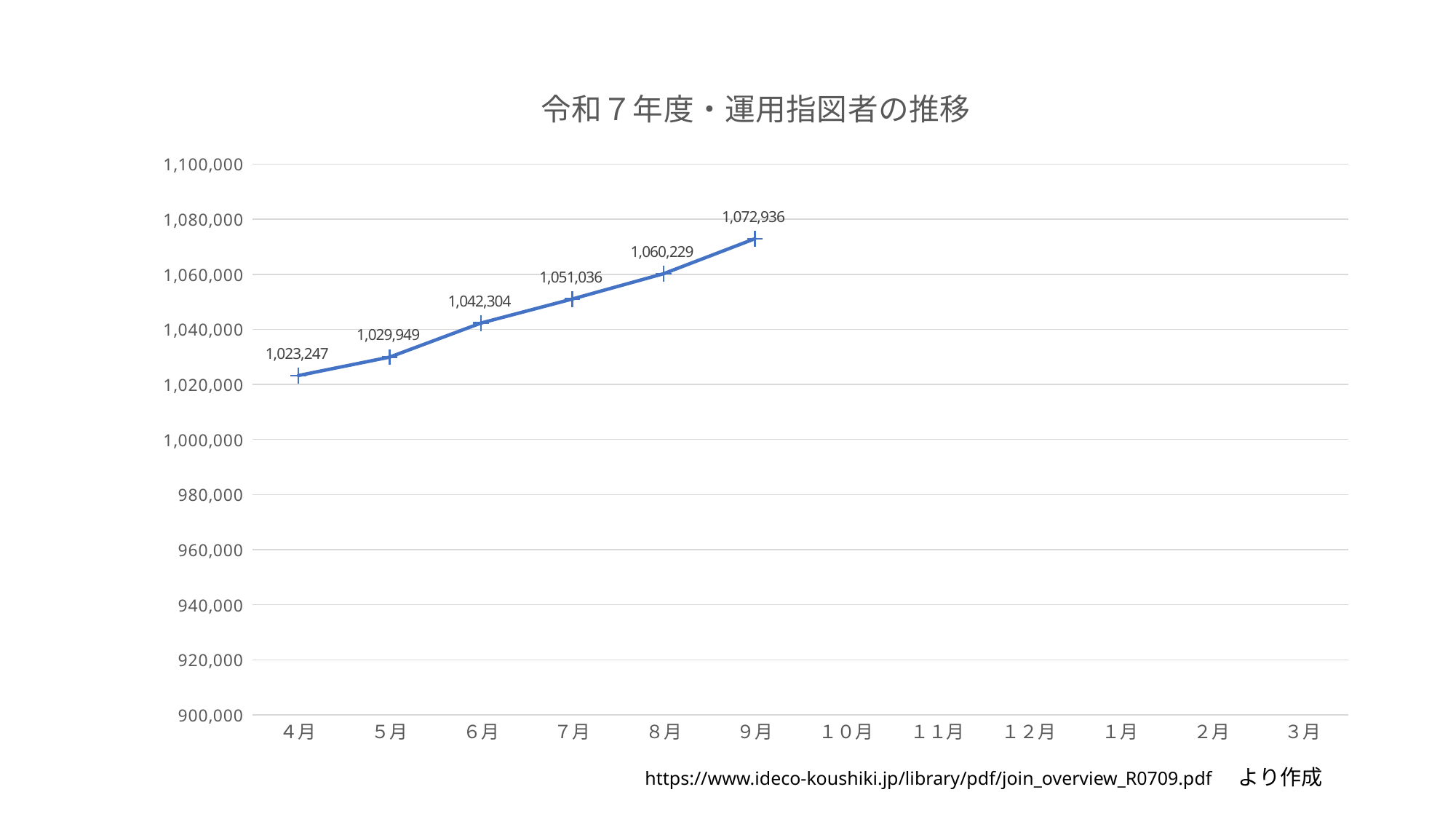
What is the value for 4月? 1,023,247 Do the values rise or fall from 4月 to 9月? rise Which is larger, the value for 8月 or the value for 6月? 8月 How many data points are plotted on the line? 6 What is the value for 7月? 1,051,036 What kind of chart is this? line chart Is the value for 8月 greater or less than 1,040,000? greater What is the difference between the values for 6月 and 5月? 12,355 What is the value for 9月? 1,072,936 What is the difference between the values for 9月 and 4月? 49,689 Which month has the lowest plotted value? 4月 Which month has the highest plotted value? 9月